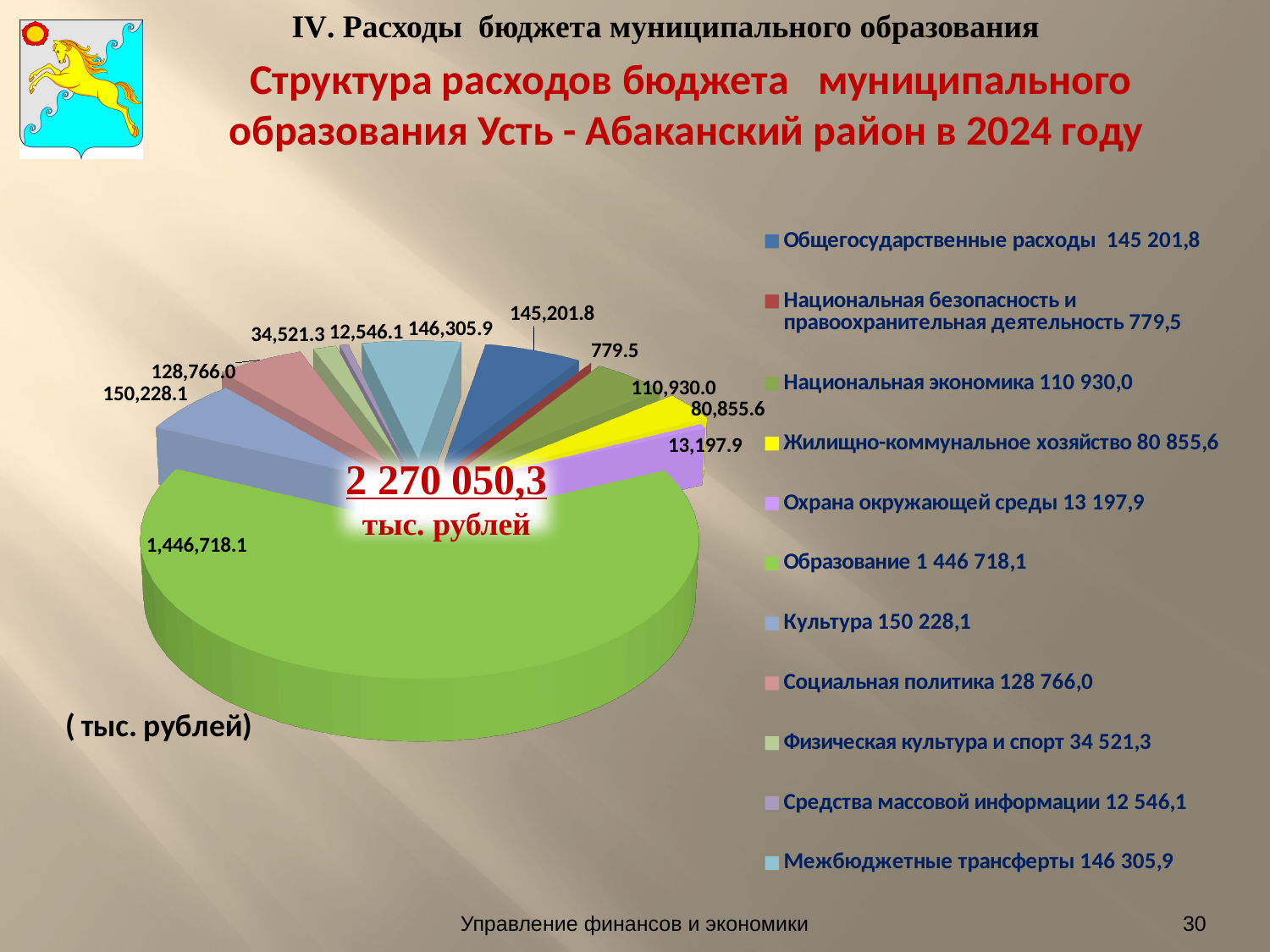
What type of chart is shown on the slide? Pie chart What share of the total 2 270 050,3 does Образование (1,446,718.1) represent? 63.7% What is the value for Средства массовой информации? 12,546.1 How many categories does the pie chart have? 11 Which category has the largest value? Образование What is the value for Образование? 1,446,718.1 Which category has the smallest value? Национальная безопасность и правоохранительная деятельность What is the difference between the values for Культура and Общегосударственные расходы? 5,026.3 What colour is the slice for Жилищно-коммунальное хозяйство? Yellow Which is larger, the value for Культура or the value for Межбюджетные трансферты? Культура What total is printed in the centre of the pie chart? 2 270 050,3 тыс. рублей What is the value for Жилищно-коммунальное хозяйство? 80,855.6